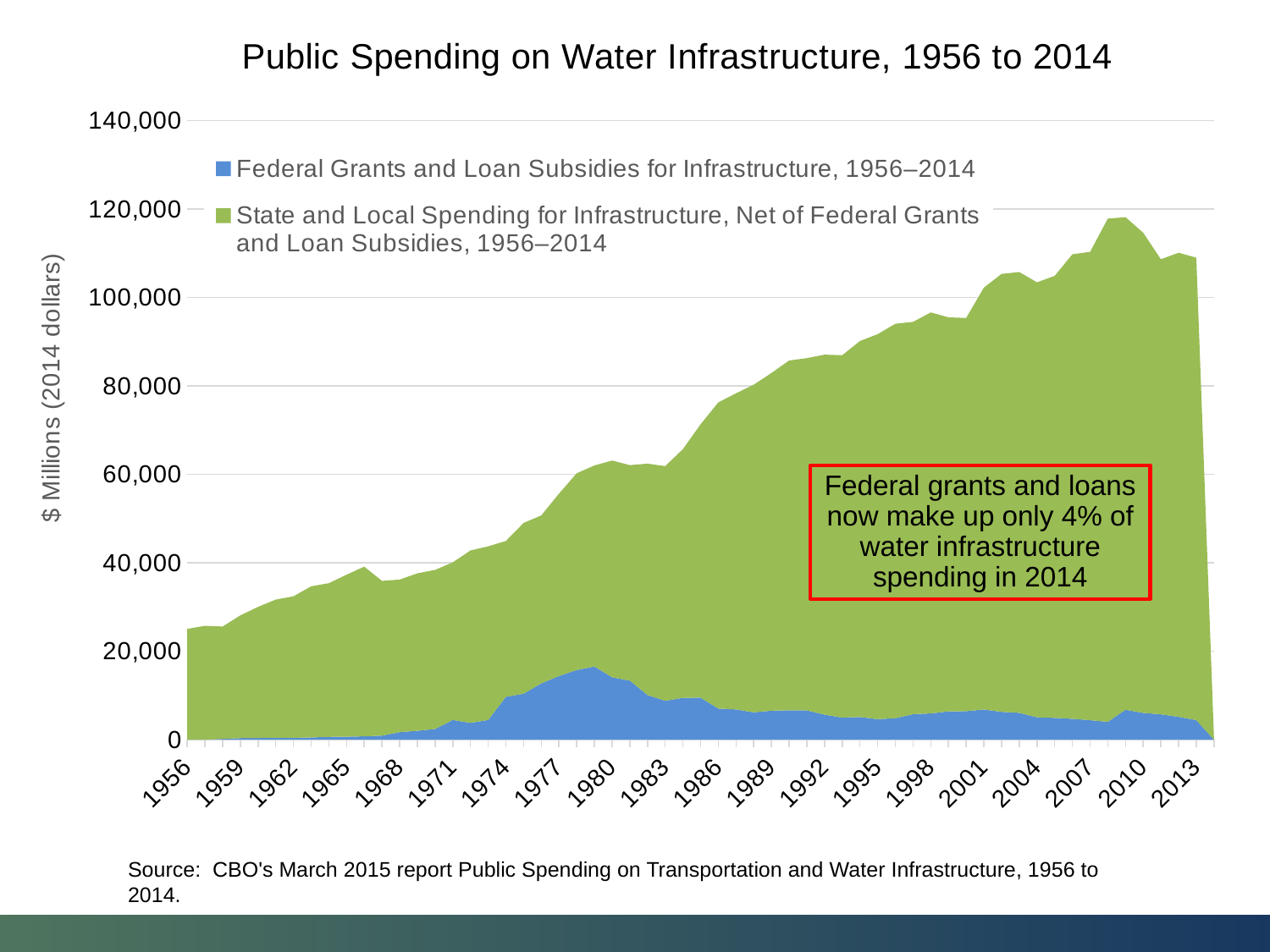
In 2013, which series is larger: Federal Grants and Loan Subsidies or State and Local Spending? State and Local Spending Is the total public spending on water infrastructure in 1956 greater or less than 20,000? greater Is the value for Federal Grants and Loan Subsidies in 1980 greater or less than 20,000? less Does total public spending on water infrastructure generally rise or fall from 1956 to 2010? rise How many series does the legend list? 2 What is the label on the vertical axis? $ Millions (2014 dollars) Is the total public spending on water infrastructure in 2010 greater or less than 100,000? greater What is the title of the chart? Public Spending on Water Infrastructure, 1956 to 2014 How many year labels are shown along the x axis? 20 What kind of chart is shown on the slide? Stacked area chart